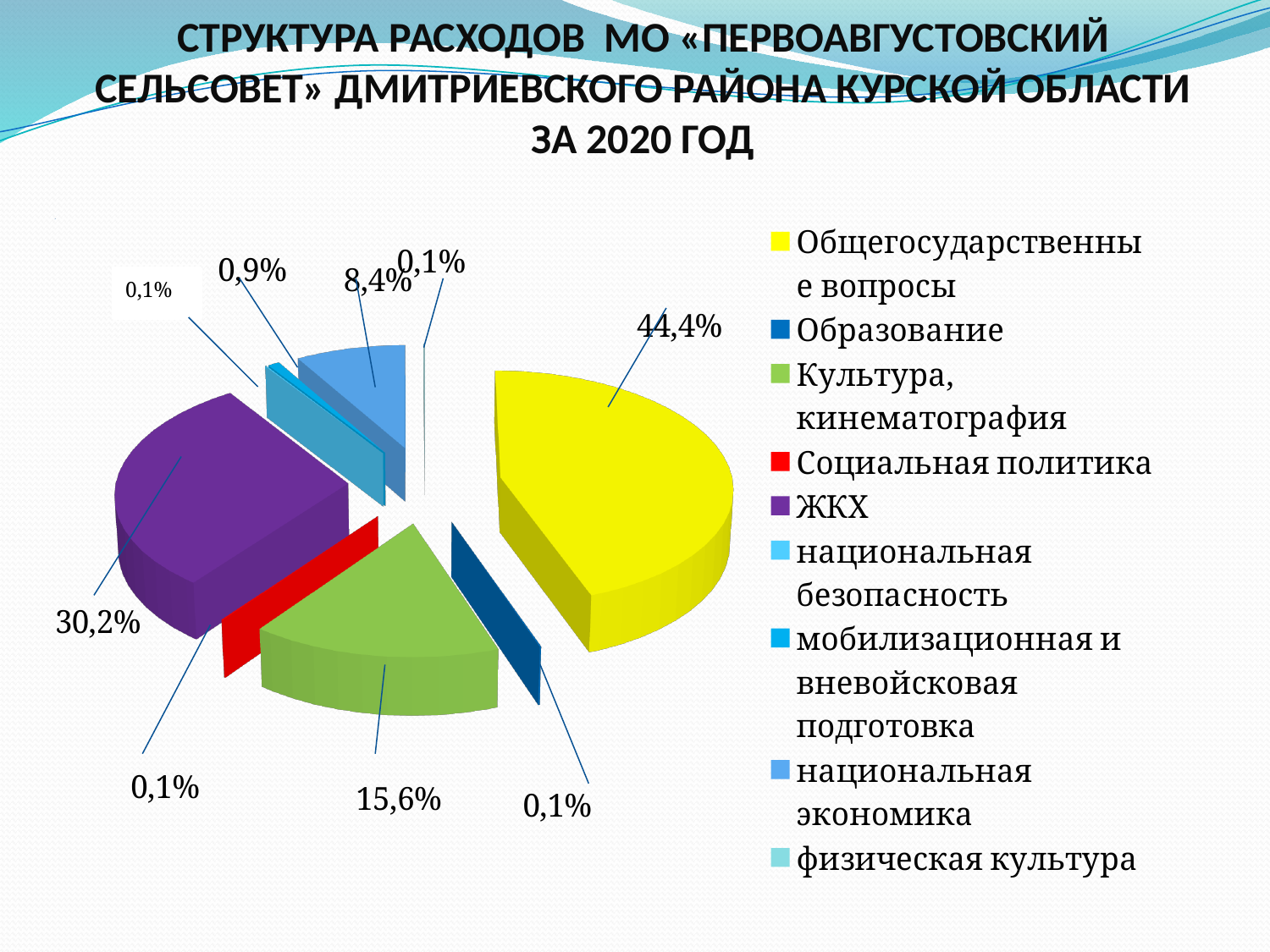
What share of expenditures is shown for мобилизационная и вневойсковая подготовка? 0,9% What share of expenditures is shown for национальная экономика? 8,4% Which has a larger share: Культура, кинематография or национальная экономика? Культура, кинематография What colour is the ЖКХ slice in the pie chart? purple Which category has the largest share of the pie chart? Общегосударственные вопросы What share of expenditures is shown for ЖКХ? 30,2% What kind of chart is shown on the slide? pie chart How many categories does the legend of the pie chart list? 9 Which year does the chart title say the expenditure structure is for? 2020 What is the difference in percentage points between the shares of Общегосударственные вопросы and ЖКХ? 14,2 What share of expenditures is shown for Общегосударственные вопросы? 44,4% What share of expenditures is shown for Культура, кинематография? 15,6%